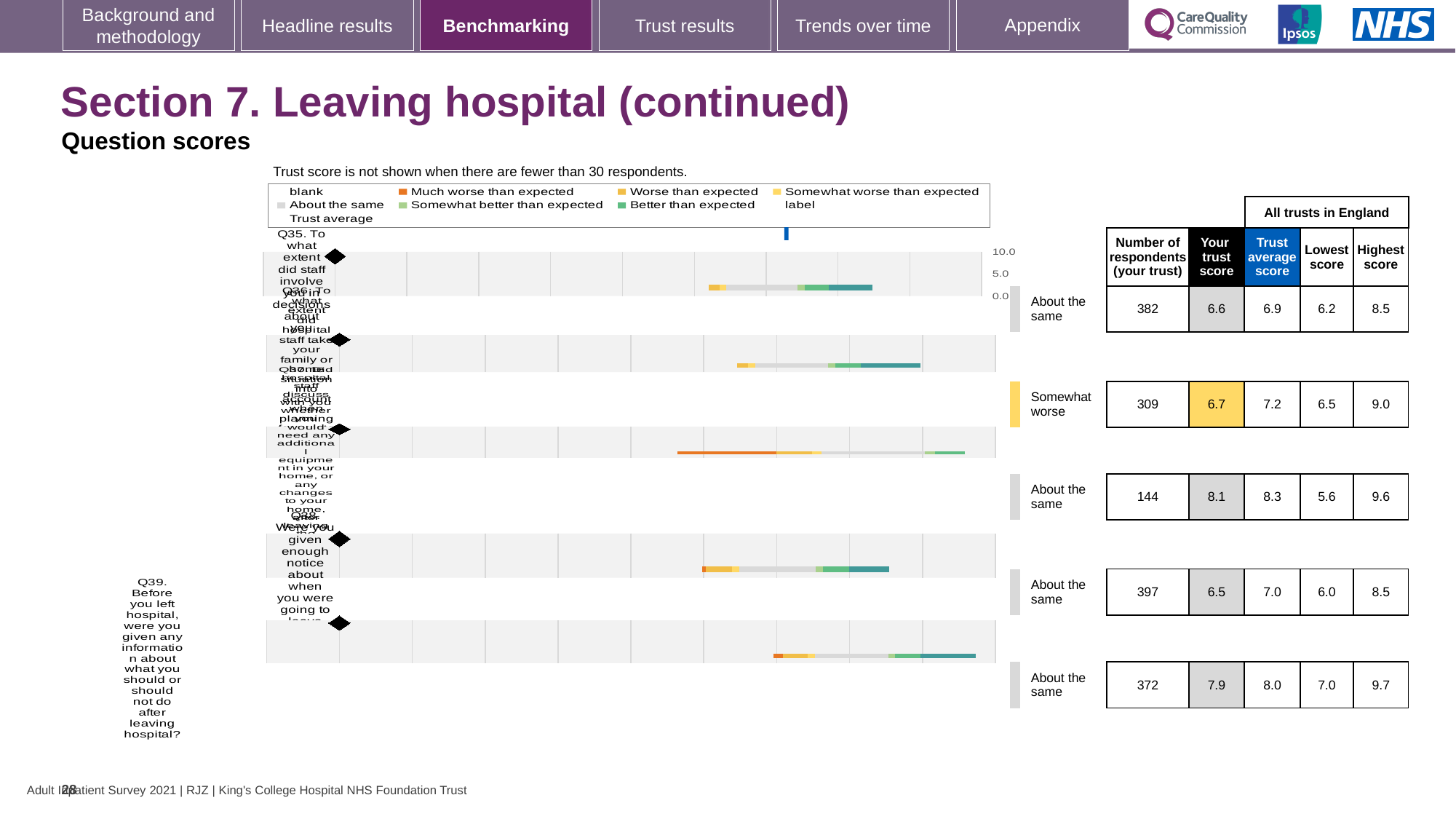
What is the number of respondents for Q39? 372 What is the trust average score for Q38 (were you given enough notice about when you were going to leave)? 7.0 Which row is rated 'Somewhat worse' rather than 'About the same'? the second row (Q36) What kind of chart is shown on the slide? bar chart What colour represents 'Much worse than expected' in the legend? orange Which row has the highest 'Your trust score' in the table? the third row (8.1) Which row has the fewest respondents? the third row (144) What is the difference between the trust average score and the trust score for Q39? 0.1 What is the trust score for Q39 (information about what you should or should not do after leaving hospital)? 7.9 Which is larger for Q35: the trust score or the trust average score? the trust average score (6.9) What is the trust score for Q35 (the first row of the chart)? 6.6 How many questions (rows) are plotted in the chart? 5